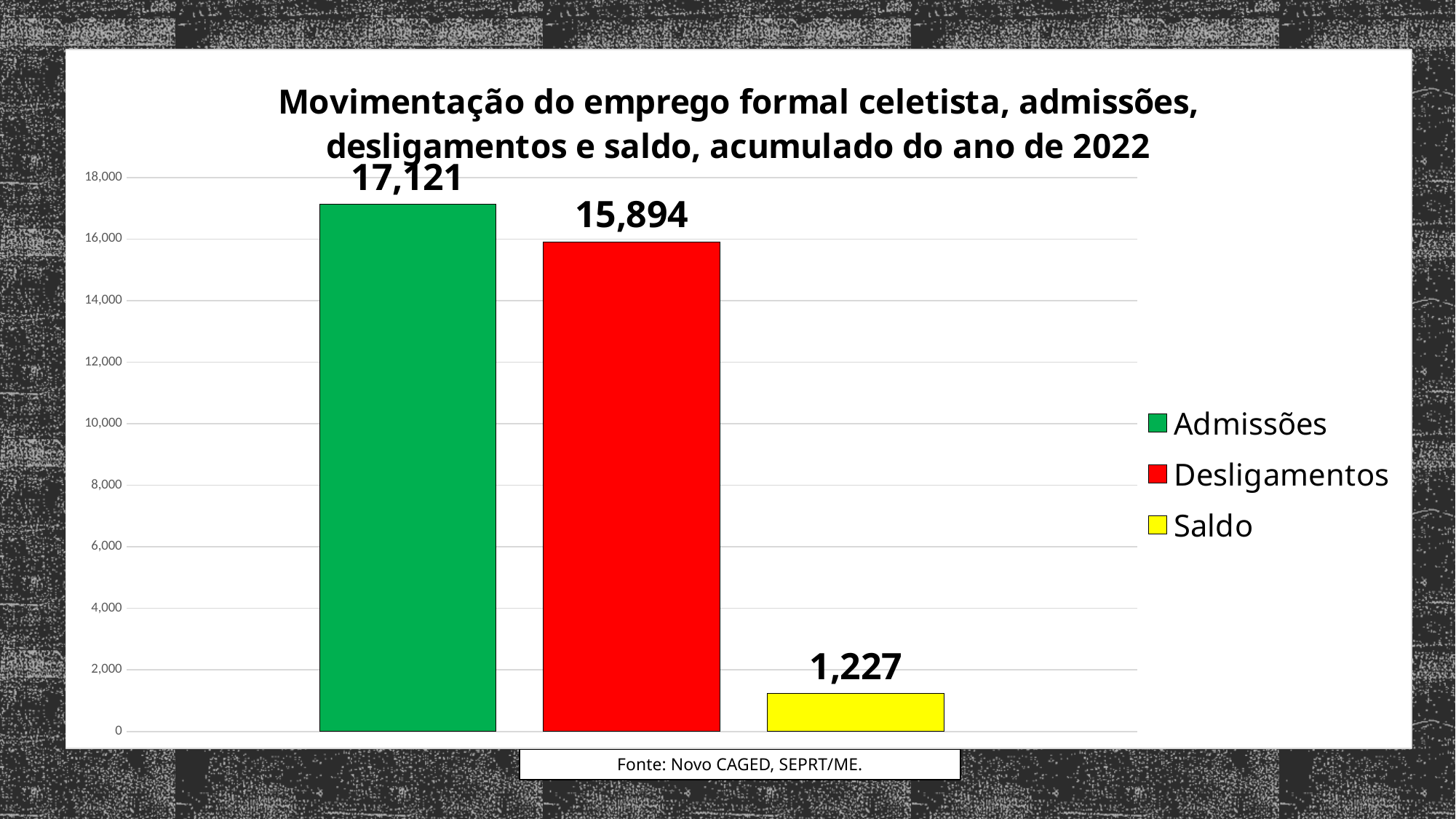
Which is larger, Admissões or Desligamentos? Admissões What is the difference between Admissões and Desligamentos? 1,227 What is the value for Admissões? 17,121 How many series does the legend list? 3 Which series has the highest value? Admissões How many bars are plotted in the chart? 3 What is the value for Saldo? 1,227 Is the value for Desligamentos greater or less than 16,000? less What kind of chart is shown on the slide? bar chart What colour is the bar for Saldo? yellow What is the value for Desligamentos? 15,894 Which series has the lowest value? Saldo